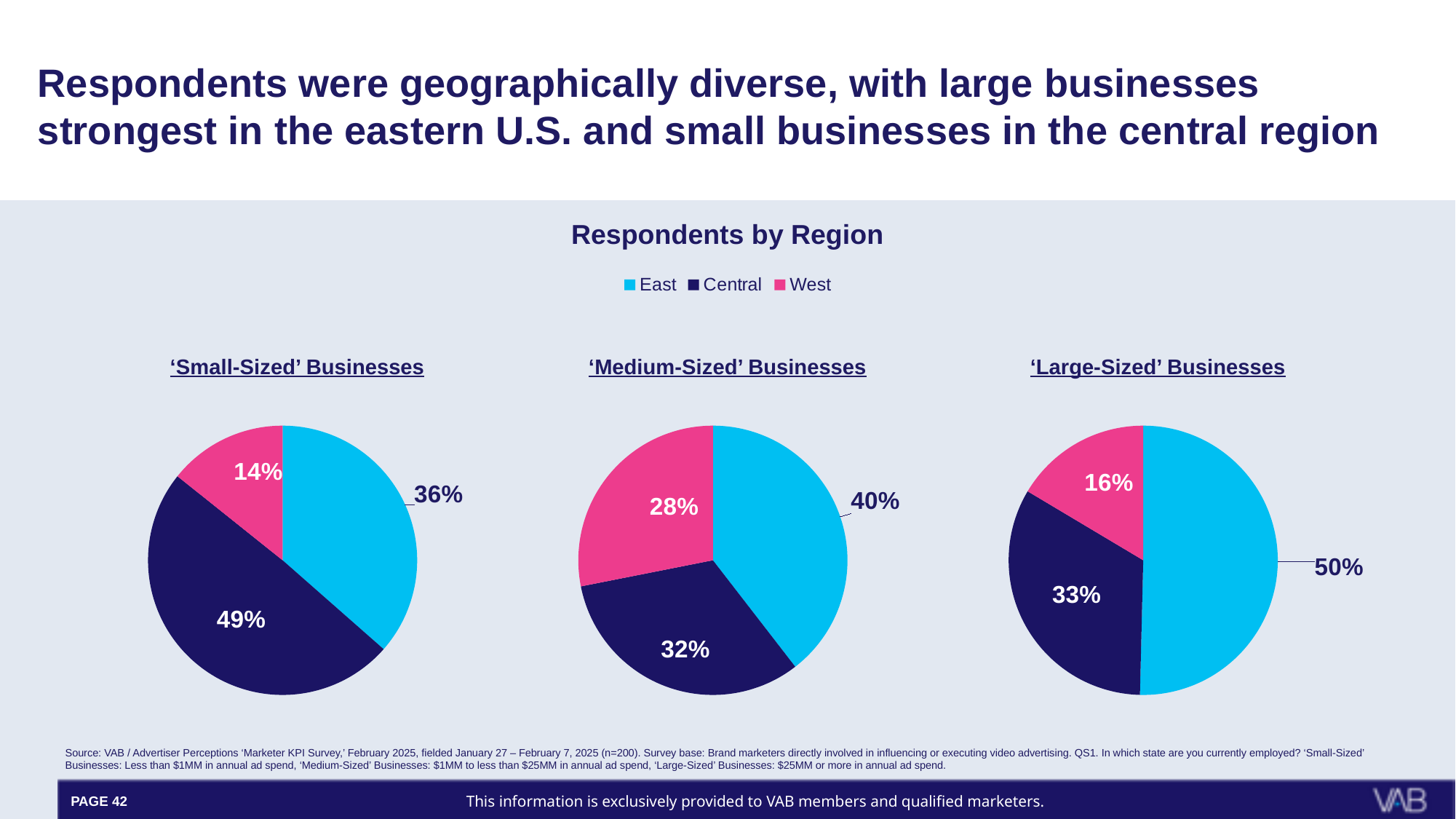
In the 'Large-Sized' Businesses pie chart, which region has the smallest share? West In the 'Medium-Sized' Businesses pie chart, what share of respondents are from the West region? 28% In the 'Small-Sized' Businesses pie chart, what is the difference between the Central and East shares? 13% In the 'Large-Sized' Businesses pie chart, what share of respondents are from the East region? 50% In the 'Small-Sized' Businesses pie chart, what share of respondents are from the Central region? 49% In the 'Large-Sized' Businesses pie chart, what is the difference between the East and Central shares? 17% In the 'Medium-Sized' Businesses pie chart, which is larger, the Central share or the West share? Central In the 'Medium-Sized' Businesses pie chart, which region has the largest share? East In the 'Small-Sized' Businesses pie chart, which region has the smallest share? West What kind of chart is used for the 'Small-Sized' Businesses data? Pie chart What is the overall title above the three pie charts? Respondents by Region How many series does the legend list for the Respondents by Region charts? 3